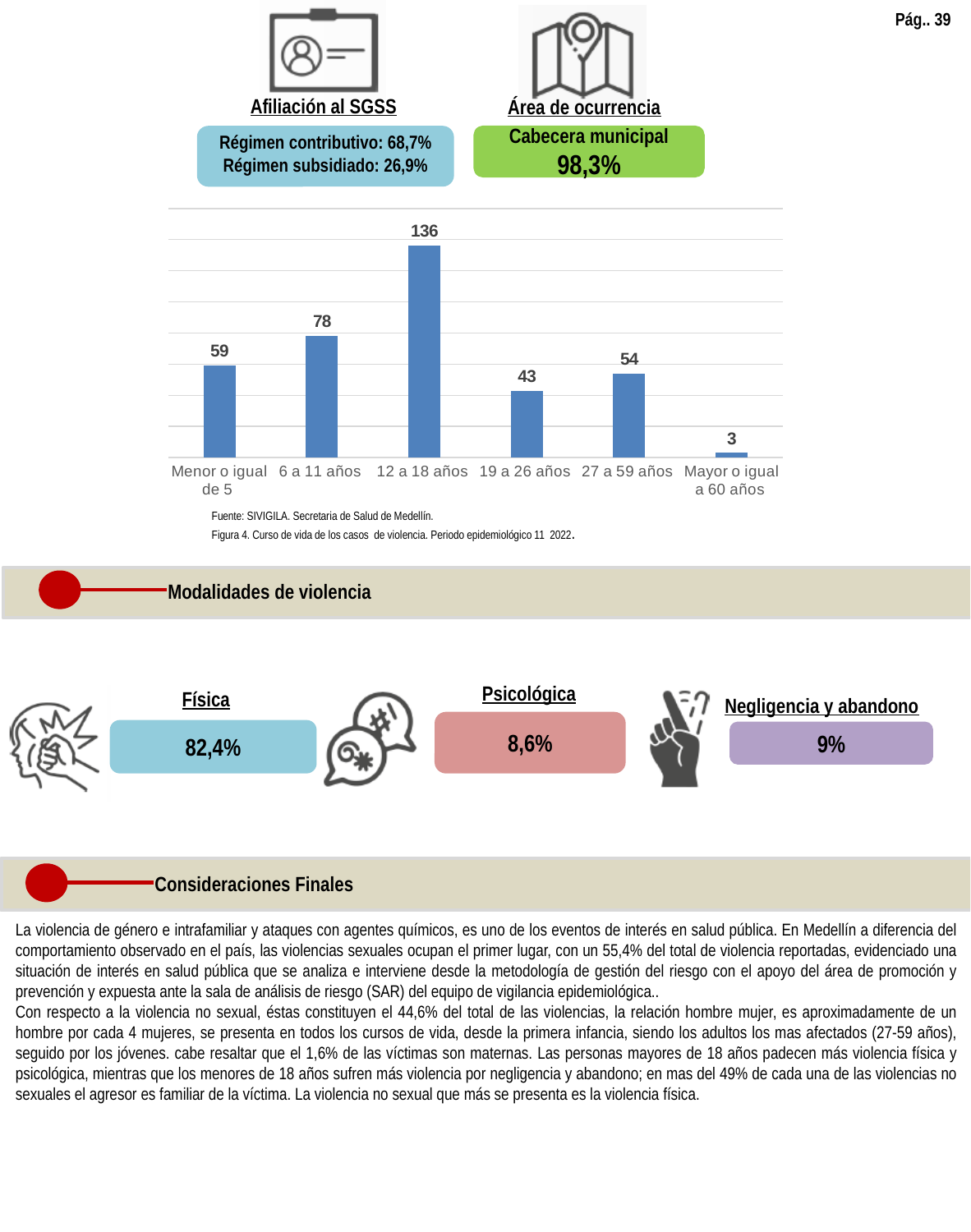
How many age categories are shown in the bar chart? 6 What kind of chart is used to show the cases by age group? Bar chart What is the value for the '12 a 18 años' category in the bar chart? 136 What is the difference between the values for '12 a 18 años' and '6 a 11 años' in the bar chart? 58 Which age group has the highest value in the bar chart? 12 a 18 años What is the value for the 'Menor o igual de 5' category in the bar chart? 59 Do the values in the bar chart rise or fall from '12 a 18 años' to '19 a 26 años'? Fall According to the caption, what is the figure number of the bar chart? Figura 4 Which age group has the lowest value in the bar chart? Mayor o igual a 60 años What is the value for the '27 a 59 años' category in the bar chart? 54 Which is larger in the bar chart: the value for '6 a 11 años' or the value for '27 a 59 años'? 6 a 11 años What is the difference between the values for '27 a 59 años' and '19 a 26 años' in the bar chart? 11